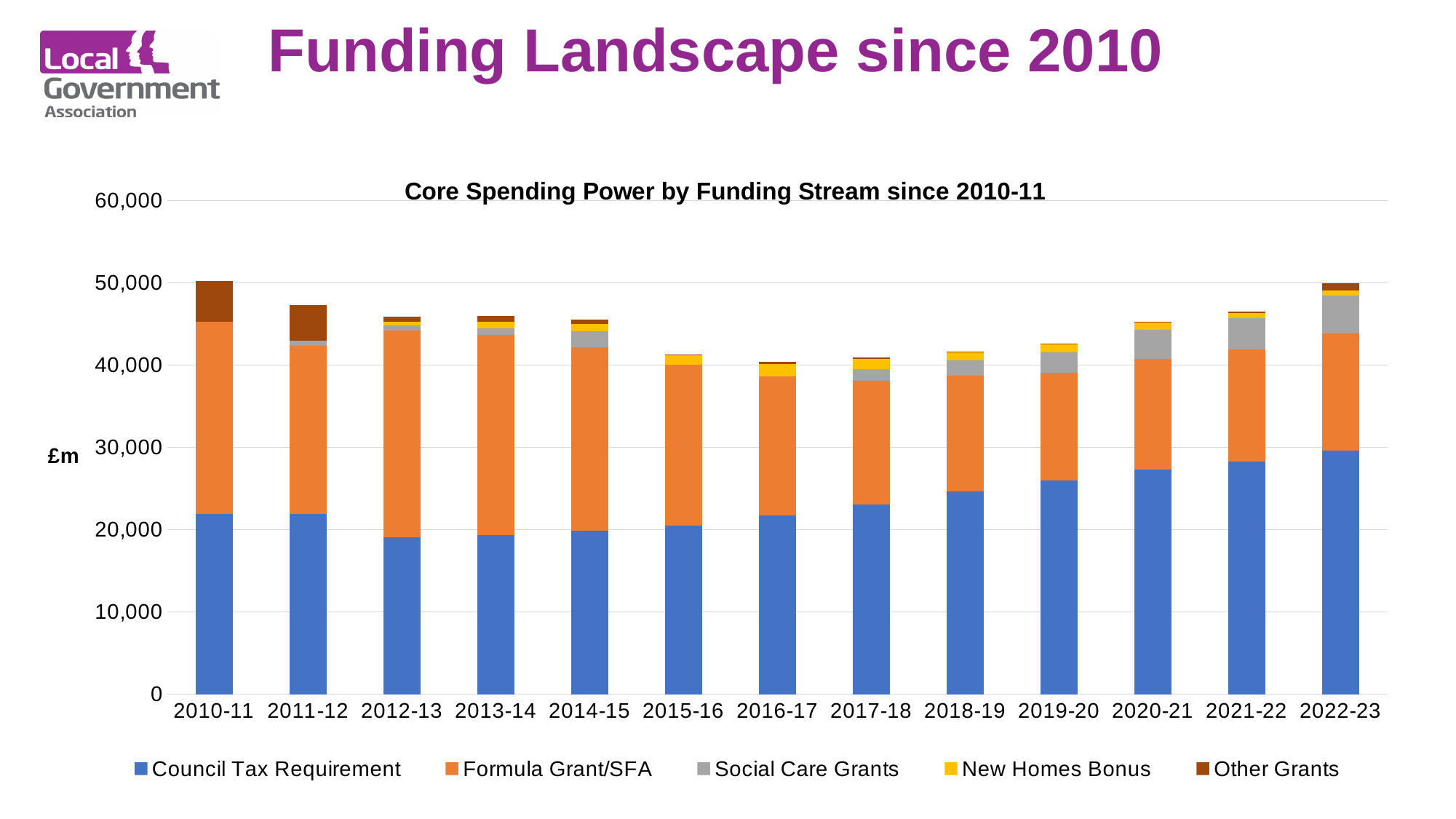
How many funding streams does the legend list? 5 Which year has the highest Council Tax Requirement? 2022-23 Is the Council Tax Requirement value for 2010-11 greater or less than 20,000? greater Does the Council Tax Requirement rise or fall from 2012-13 to 2022-23? rise What kind of chart is shown on the slide? Stacked bar chart What unit is shown on the vertical axis label? £m How many financial years are shown on the x axis of the chart? 13 Which is larger, the Formula Grant/SFA segment for 2010-11 or for 2016-17? 2010-11 Is the Council Tax Requirement value for 2012-13 greater or less than 20,000? less Is the total stacked bar for 2015-16 greater or less than 40,000? greater What is the title of the chart? Core Spending Power by Funding Stream since 2010-11